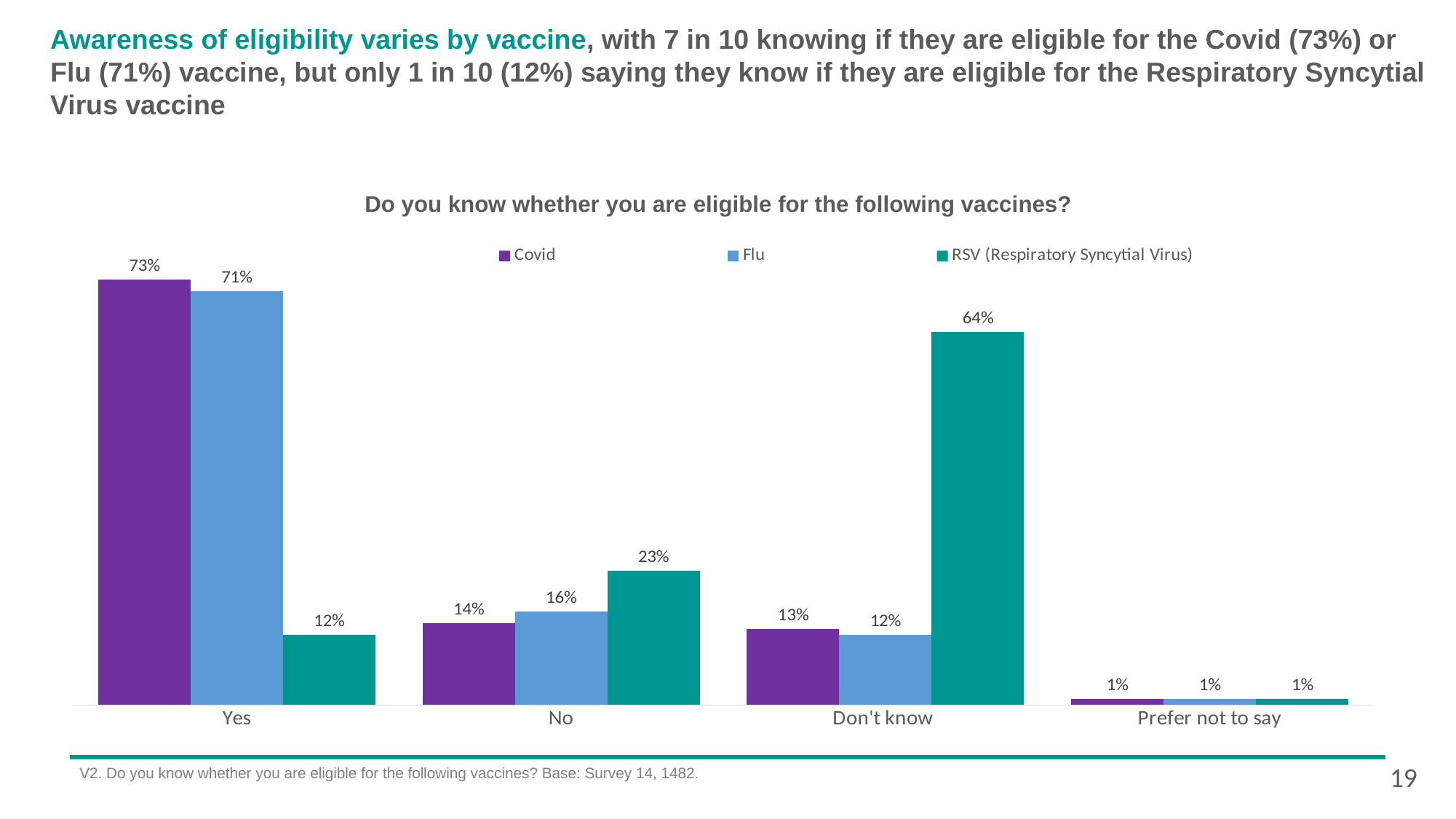
What is the title of the chart? Do you know whether you are eligible for the following vaccines? What percentage of respondents said 'Yes' for the Covid vaccine? 73% Which vaccine has the highest 'Yes' value? Covid How many series does the legend list? 3 What is the difference between the 'Yes' values for Covid and RSV (Respiratory Syncytial Virus)? 61% What percentage of respondents said 'No' for the Flu vaccine? 16% How many response categories are shown on the x axis? 4 Which vaccine has the lowest 'Yes' value? RSV (Respiratory Syncytial Virus) What kind of chart is shown on the slide? Bar chart Which is larger: the 'No' value for RSV (Respiratory Syncytial Virus) or the 'No' value for Covid? RSV (Respiratory Syncytial Virus) What is the 'Prefer not to say' value for the Flu vaccine? 1% What percentage of respondents said 'Don't know' for the RSV (Respiratory Syncytial Virus) vaccine? 64%